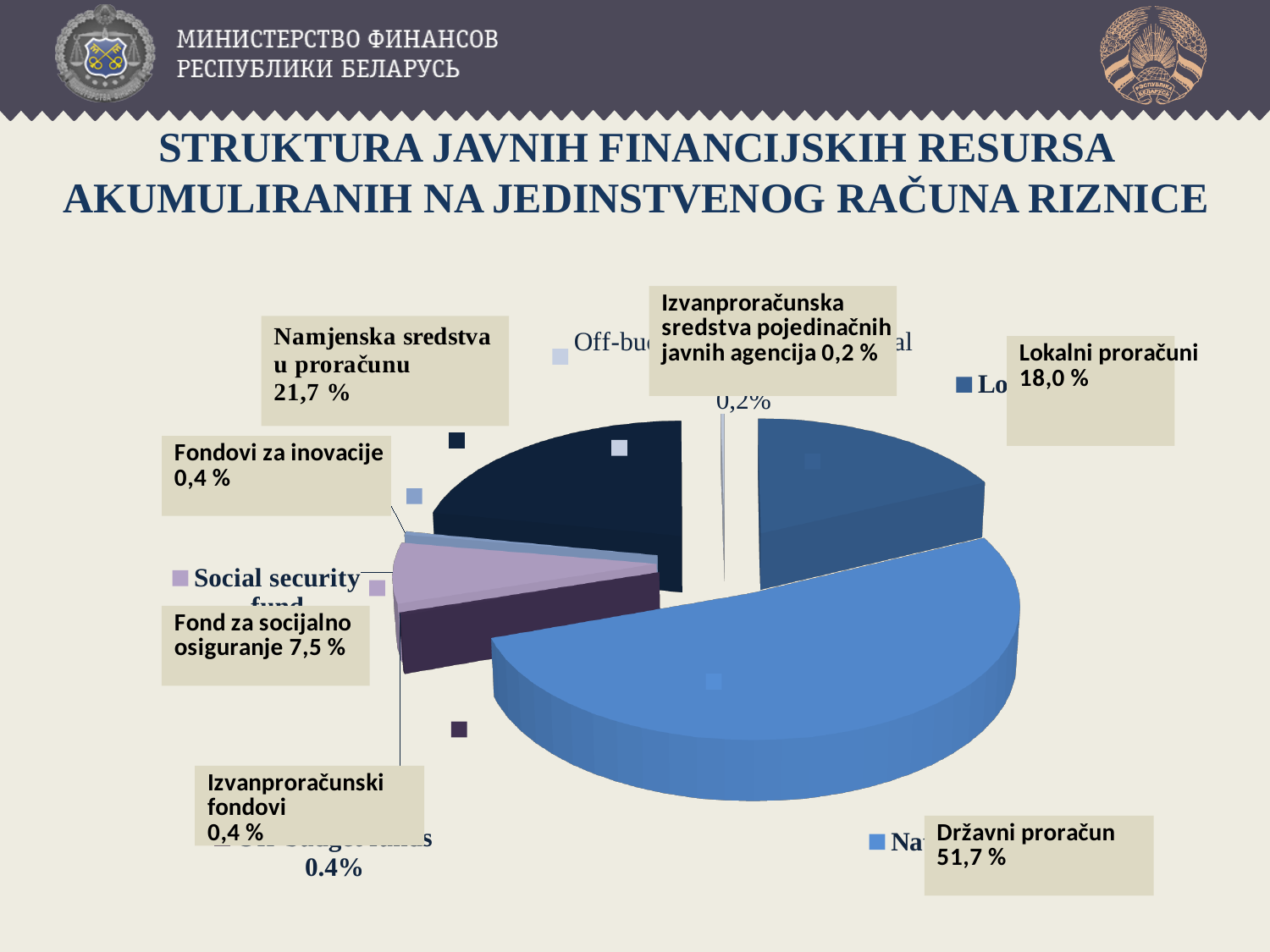
Which is larger: the share of Lokalni proračuni or the share of Namjenska sredstva u proračunu? Namjenska sredstva u proračunu Which category has the smallest share of the pie chart? Izvanproračunska sredstva pojedinačnih javnih agencija What share does Namjenska sredstva u proračunu have in the pie chart? 21,7 % What share does Fond za socijalno osiguranje have in the pie chart? 7,5 % What share does Lokalni proračuni have in the pie chart? 18,0 % How many categories are labelled in the pie chart? 7 What share does Izvanproračunska sredstva pojedinačnih javnih agencija have in the pie chart? 0,2 % Which category has the largest share of the pie chart? Državni proračun What kind of chart is shown on the slide? pie chart What share does Državni proračun have in the pie chart? 51,7 % What is the difference in percentage points between the share of Državni proračun and the share of Lokalni proračuni? 33,7 What share does Fondovi za inovacije have in the pie chart? 0,4 %